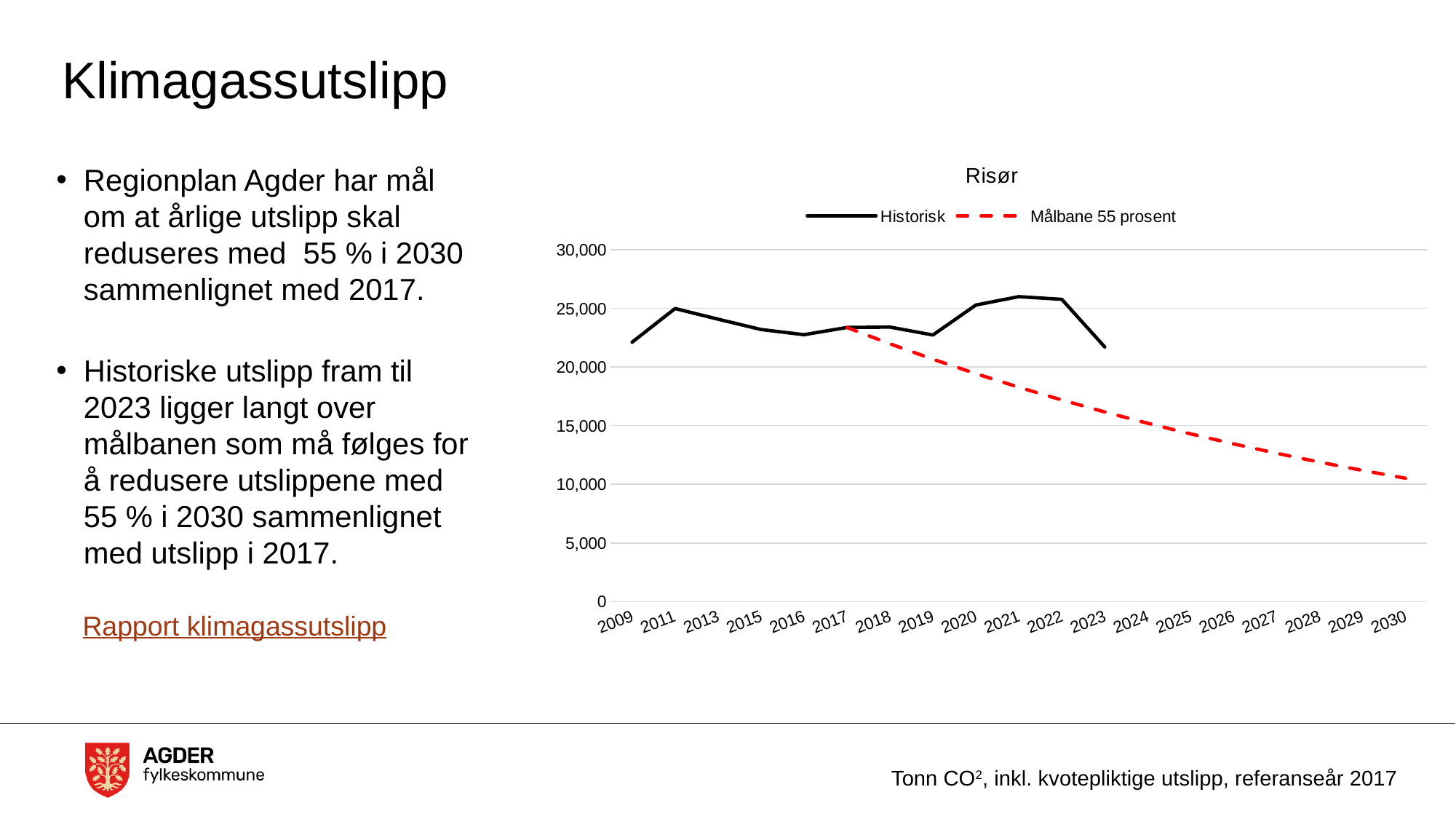
How many series does the chart legend list? 2 Is the Målbane 55 prosent value for 2030 greater or less than 15,000? less What kind of chart is shown on the slide? line chart Is the Historisk value for 2011 greater or less than 20,000? greater Is the Historisk value for 2016 greater or less than 25,000? less What is the title of the chart? Risør How many years are labelled on the x axis of the chart? 19 Does the Målbane 55 prosent line rise or fall from 2017 to 2030? fall Which series is drawn as a red dashed line? Målbane 55 prosent In 2023, which series has the larger value, Historisk or Målbane 55 prosent? Historisk